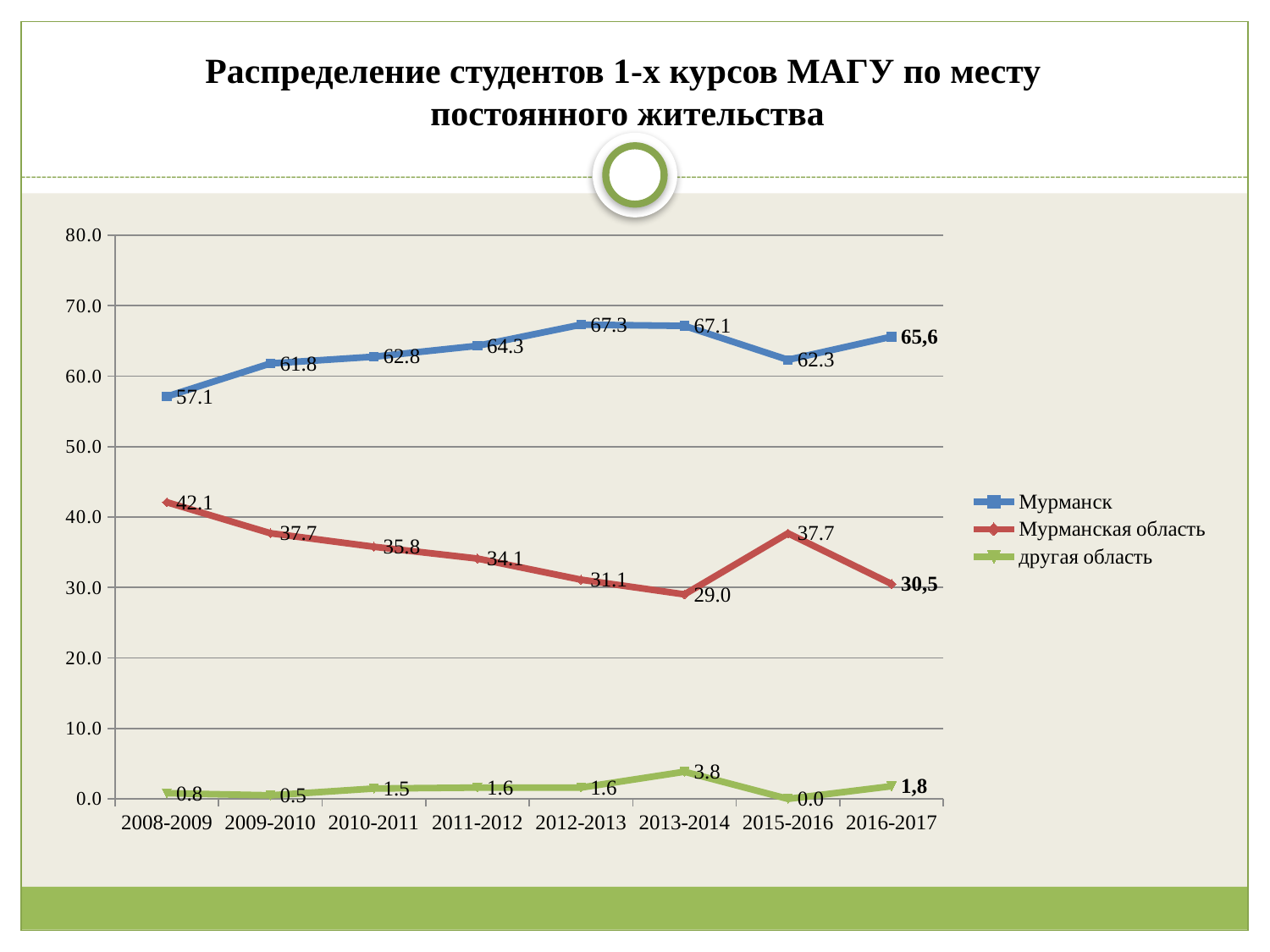
What is the value for Мурманская область in 2013-2014? 29.0 By how much did the value for Мурманск increase from 2008-2009 to 2009-2010? 4.7 For Мурманская область, which year has the larger value: 2008-2009 or 2015-2016? 2008-2009 What kind of chart is shown on the slide? line chart In which academic year is the value for Мурманск the highest? 2012-2013 Does the value for Мурманская область rise or fall from 2008-2009 to 2013-2014? fall In which academic year is the value for другая область the lowest? 2015-2016 What is the value for другая область in 2016-2017? 1,8 How many academic years are shown on the x axis? 8 What is the value for Мурманск in 2008-2009? 57.1 How many series does the legend list? 3 What colour is the line for Мурманск? blue